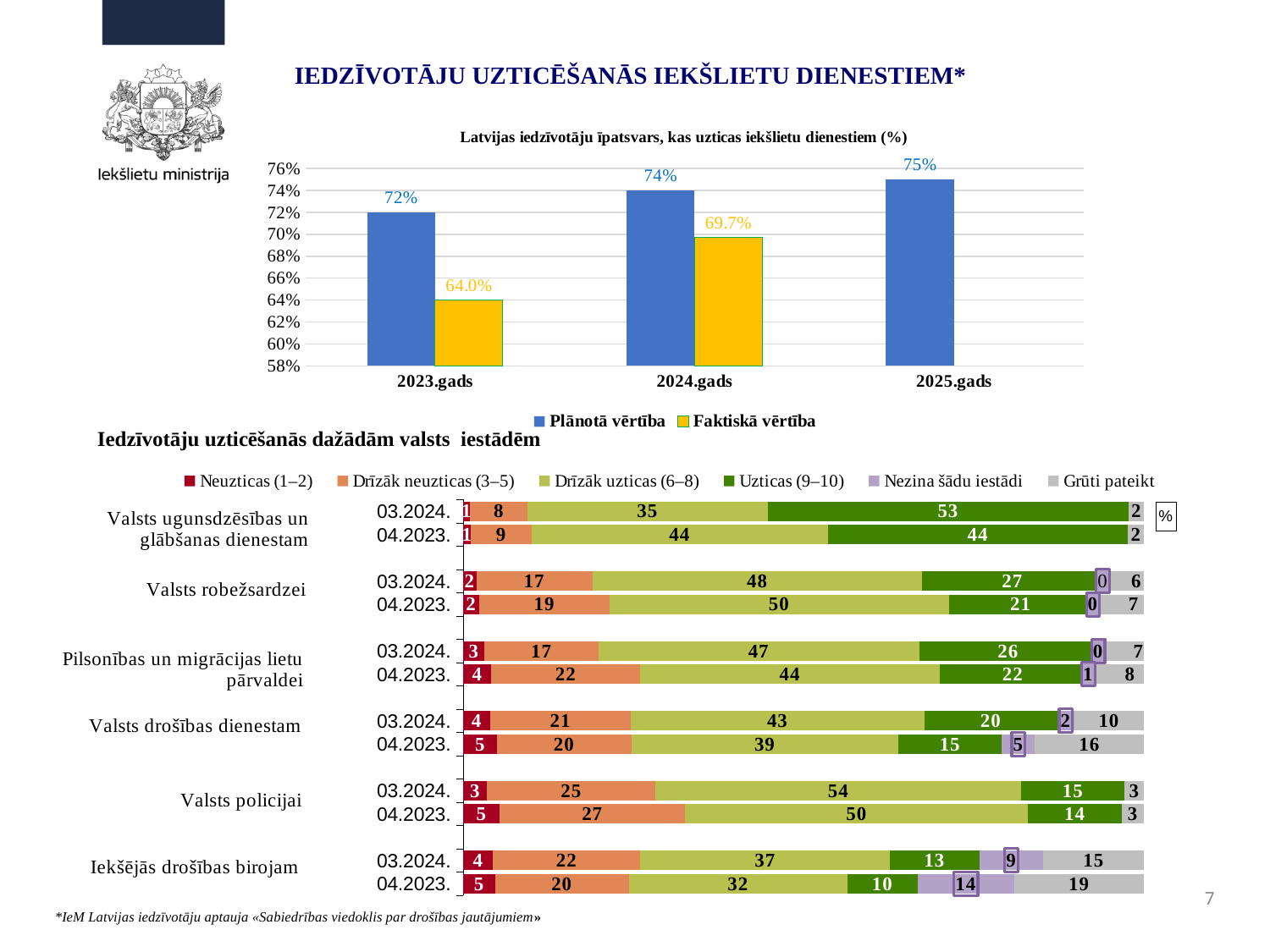
In the top chart 'Latvijas iedzīvotāju īpatsvars, kas uzticas iekšlietu dienestiem (%)', how many series does the legend list? 2 In the top chart 'Latvijas iedzīvotāju īpatsvars, kas uzticas iekšlietu dienestiem (%)', what kind of chart is it? Bar chart In the bottom chart 'Iedzīvotāju uzticēšanās dažādām valsts iestādēm', what is the Drīzāk uzticas (6–8) value for Valsts policijai in 03.2024.? 54 In the top chart 'Latvijas iedzīvotāju īpatsvars, kas uzticas iekšlietu dienestiem (%)', does the Plānotā vērtība rise or fall from 2023.gads to 2025.gads? Rise In the bottom chart 'Iedzīvotāju uzticēšanās dažādām valsts iestādēm', how many series does the legend list? 6 In the bottom chart 'Iedzīvotāju uzticēšanās dažādām valsts iestādēm', what is the Uzticas (9–10) value for Valsts ugunsdzēsības un glābšanas dienestam in 03.2024.? 53 In the top chart 'Latvijas iedzīvotāju īpatsvars, kas uzticas iekšlietu dienestiem (%)', what is the Faktiskā vērtība for 2023.gads? 64.0% In the bottom chart 'Iedzīvotāju uzticēšanās dažādām valsts iestādēm', what is the Grūti pateikt value for Iekšējās drošības birojam in 04.2023.? 19 In the top chart 'Latvijas iedzīvotāju īpatsvars, kas uzticas iekšlietu dienestiem (%)', which is larger for 2024.gads: Plānotā vērtība or Faktiskā vērtība? Plānotā vērtība In the bottom chart 'Iedzīvotāju uzticēšanās dažādām valsts iestādēm', what is the difference between the Uzticas (9–10) values for Valsts ugunsdzēsības un glābšanas dienestam in 03.2024. and 04.2023.? 9 In the top chart 'Latvijas iedzīvotāju īpatsvars, kas uzticas iekšlietu dienestiem (%)', which year has the highest Plānotā vērtība? 2025.gads In the top chart 'Latvijas iedzīvotāju īpatsvars, kas uzticas iekšlietu dienestiem (%)', what is the Plānotā vērtība for 2024.gads? 74%